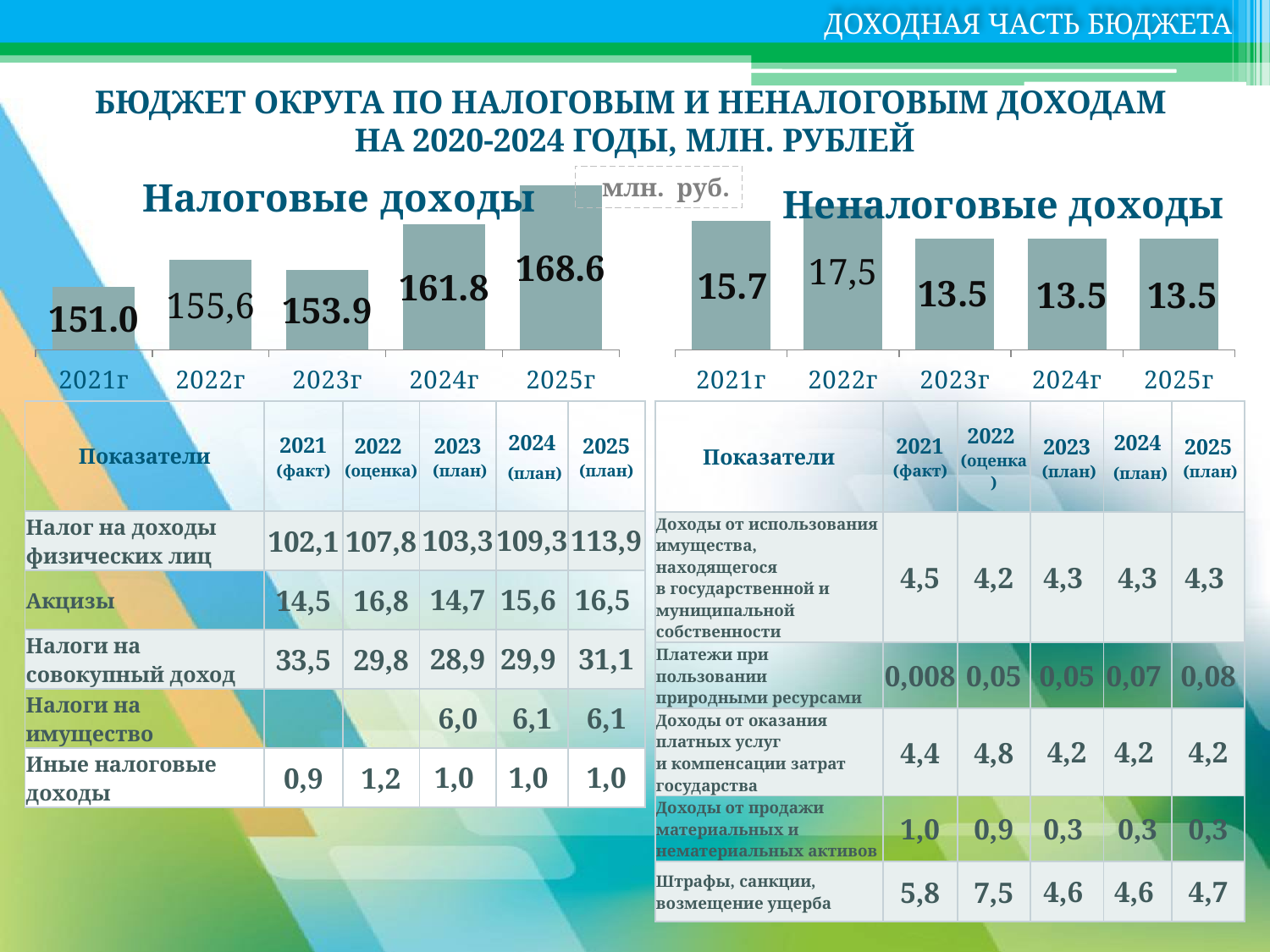
In the 'Налоговые доходы' chart, what is the difference between the values for 2025г and 2021г? 17.6 In the 'Налоговые доходы' chart, which is larger, the value for 2022г or the value for 2023г? 2022г How many years are shown in the 'Налоговые доходы' chart? 5 In the 'Неналоговые доходы' chart, what is the value for 2021г? 15.7 In the 'Налоговые доходы' chart, which year has the lowest value? 2021г What kind of chart is the 'Неналоговые доходы' chart? bar chart In the 'Неналоговые доходы' chart, which year has the highest value? 2022г In the 'Неналоговые доходы' chart, what is the difference between the values for 2022г and 2021г? 1.8 In the 'Неналоговые доходы' chart, which is larger, the value for 2021г or the value for 2024г? 2021г In the 'Налоговые доходы' chart, which year has the highest value? 2025г In the 'Налоговые доходы' chart, what is the value for 2024г? 161.8 In the 'Налоговые доходы' chart, what is the value for 2022г? 155,6